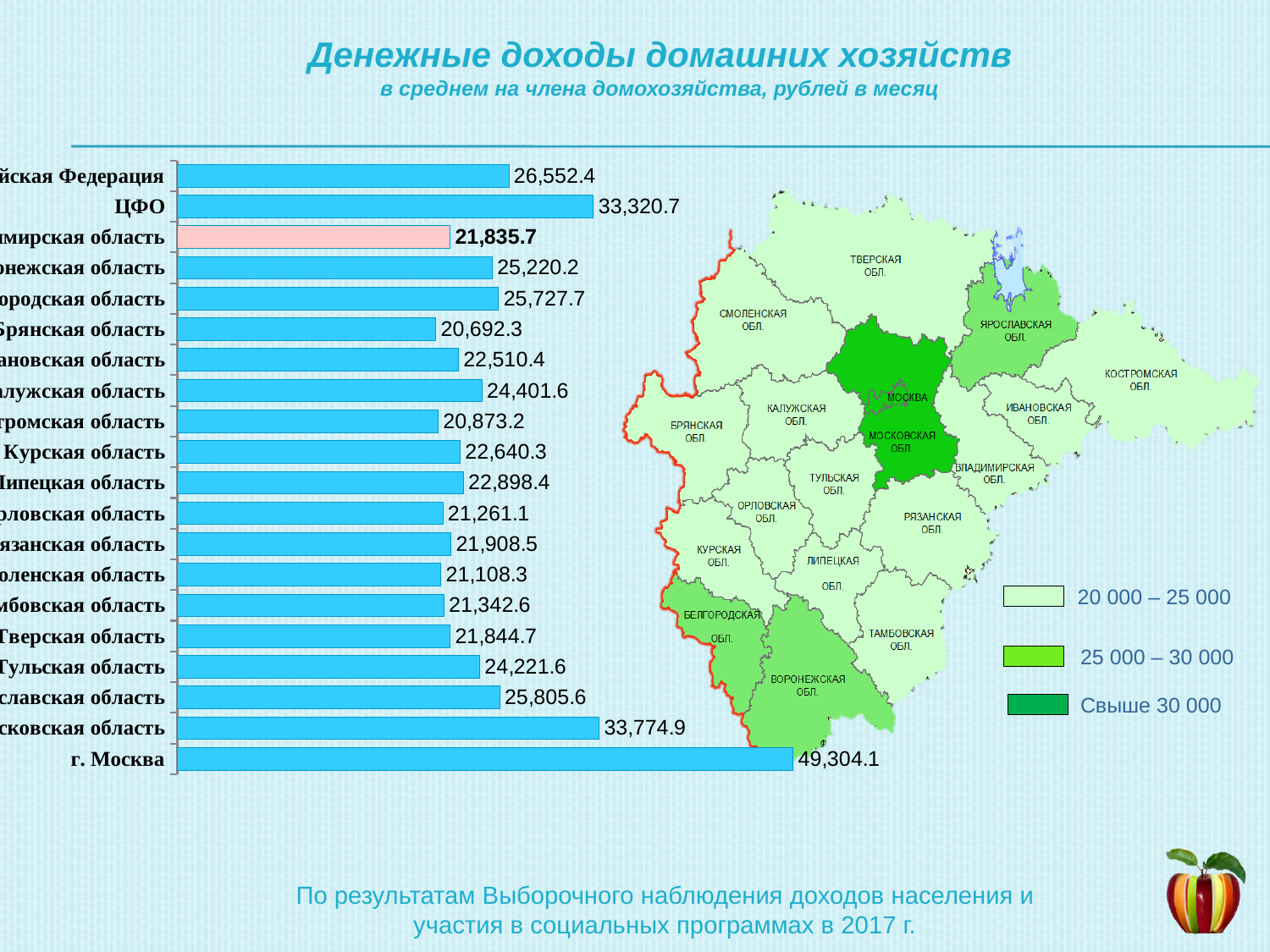
What is the difference between the values for г. Москва and ЦФО? 15,983.4 How many bars are in the chart? 20 What is the value for Тверская область? 21,844.7 Which is larger, the value for Тульская область or Курская область? Тульская область Which category has the highest value? г. Москва What is the value for Тульская область? 24,221.6 Which category has the lowest value? Брянская область What is the value for Курская область? 22,640.3 What is the value for г. Москва? 49,304.1 What kind of chart is shown on the slide? Bar chart What is the difference between the values for ЦФО and Тульская область? 9,099.1 What is the value for ЦФО? 33,320.7